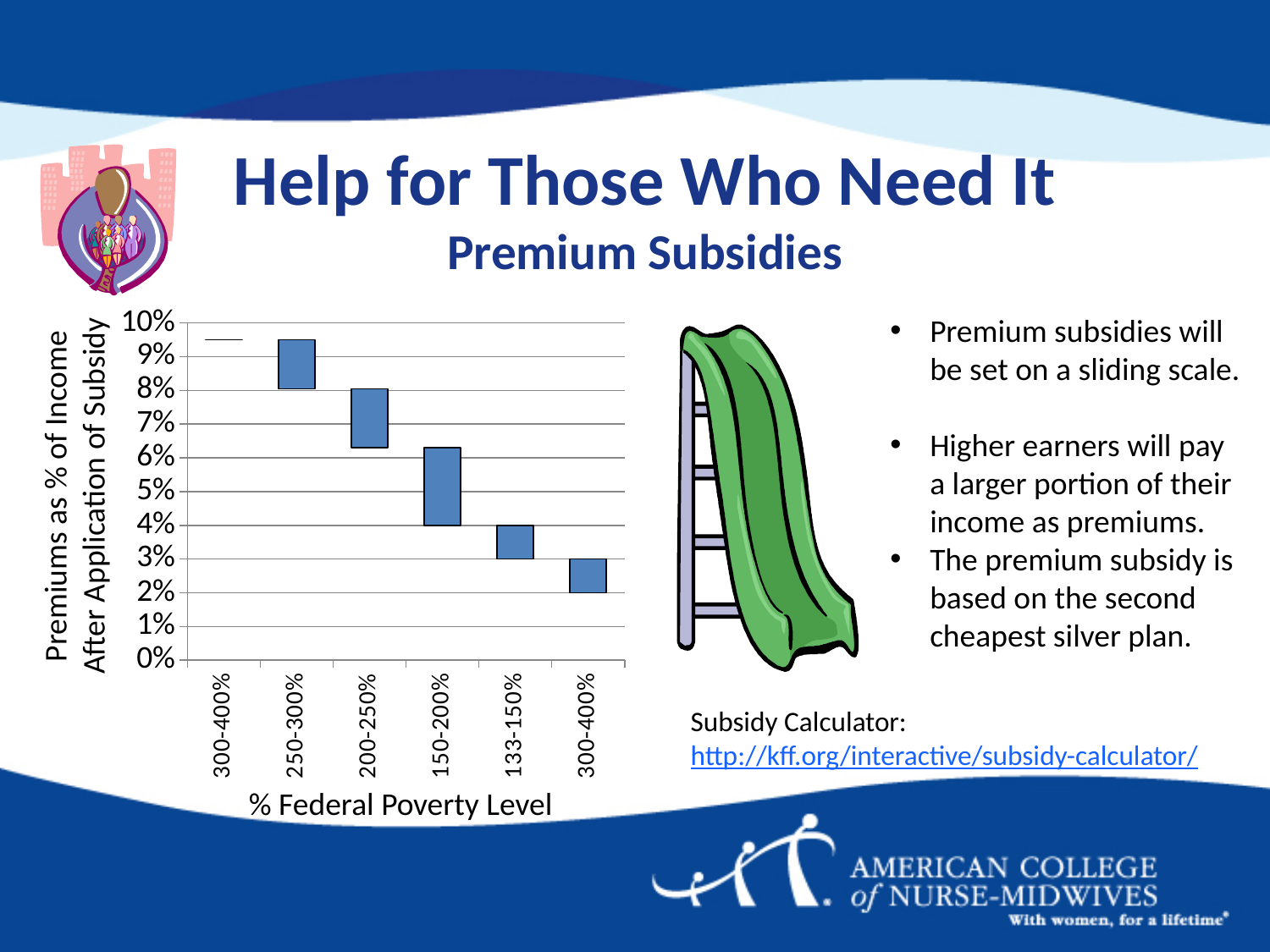
Is the top of the rightmost bar (300-400%) greater or less than 4%? less Do the bars rise or fall moving from left to right along the x axis? fall What kind of chart is shown on the slide? bar chart Is the bottom of the bar for 150-200% greater or less than 5%? less Is the top of the bar for 200-250% greater or less than 7%? greater Which bar is positioned higher on the chart, the one for 133-150% or the rightmost bar for 300-400%? 133-150% How many categories are shown along the x axis of the chart? 6 What is the title of the x axis of the chart? % Federal Poverty Level Which bar is positioned higher on the chart, the one for 200-250% or the one for 150-200%? 200-250% What is the title of the y axis of the chart? Premiums as % of Income After Application of Subsidy